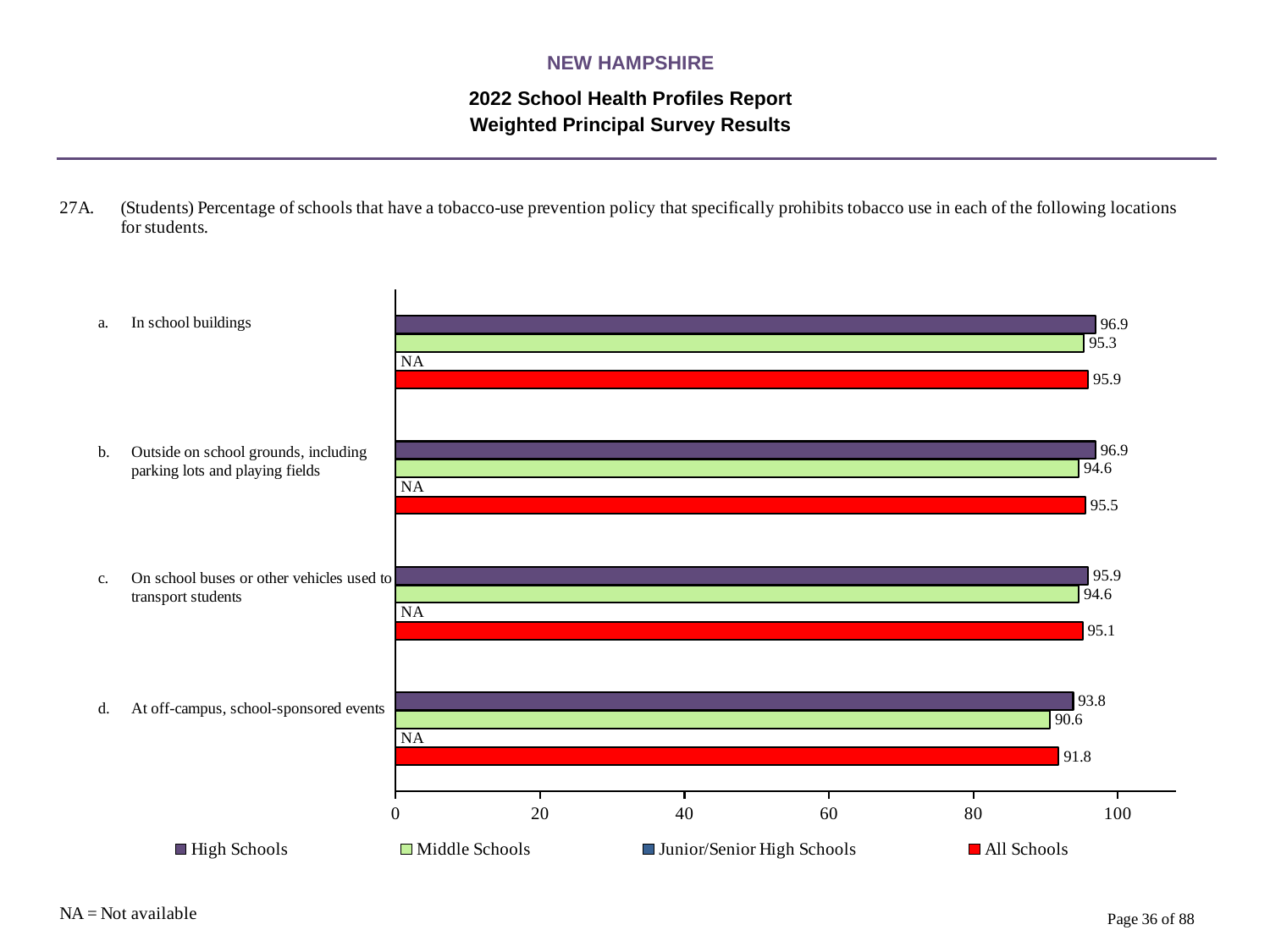
What is the High Schools value for 'In school buildings'? 96.9 Is the All Schools value for 'At off-campus, school-sponsored events' greater or less than 80? greater How many locations (categories) are shown on the chart? 4 What value is shown for Junior/Senior High Schools for 'Outside on school grounds, including parking lots and playing fields'? NA What is the Middle Schools value for 'At off-campus, school-sponsored events'? 90.6 What kind of chart is shown on the slide? bar chart How many series does the legend list? 4 What is the difference between the High Schools and Middle Schools values for 'At off-campus, school-sponsored events'? 3.2 Which is larger for 'In school buildings': the High Schools value or the All Schools value? High Schools Which location has the lowest Middle Schools value? At off-campus, school-sponsored events What is the All Schools value for 'On school buses or other vehicles used to transport students'? 95.1 Which location has the lowest All Schools value? At off-campus, school-sponsored events